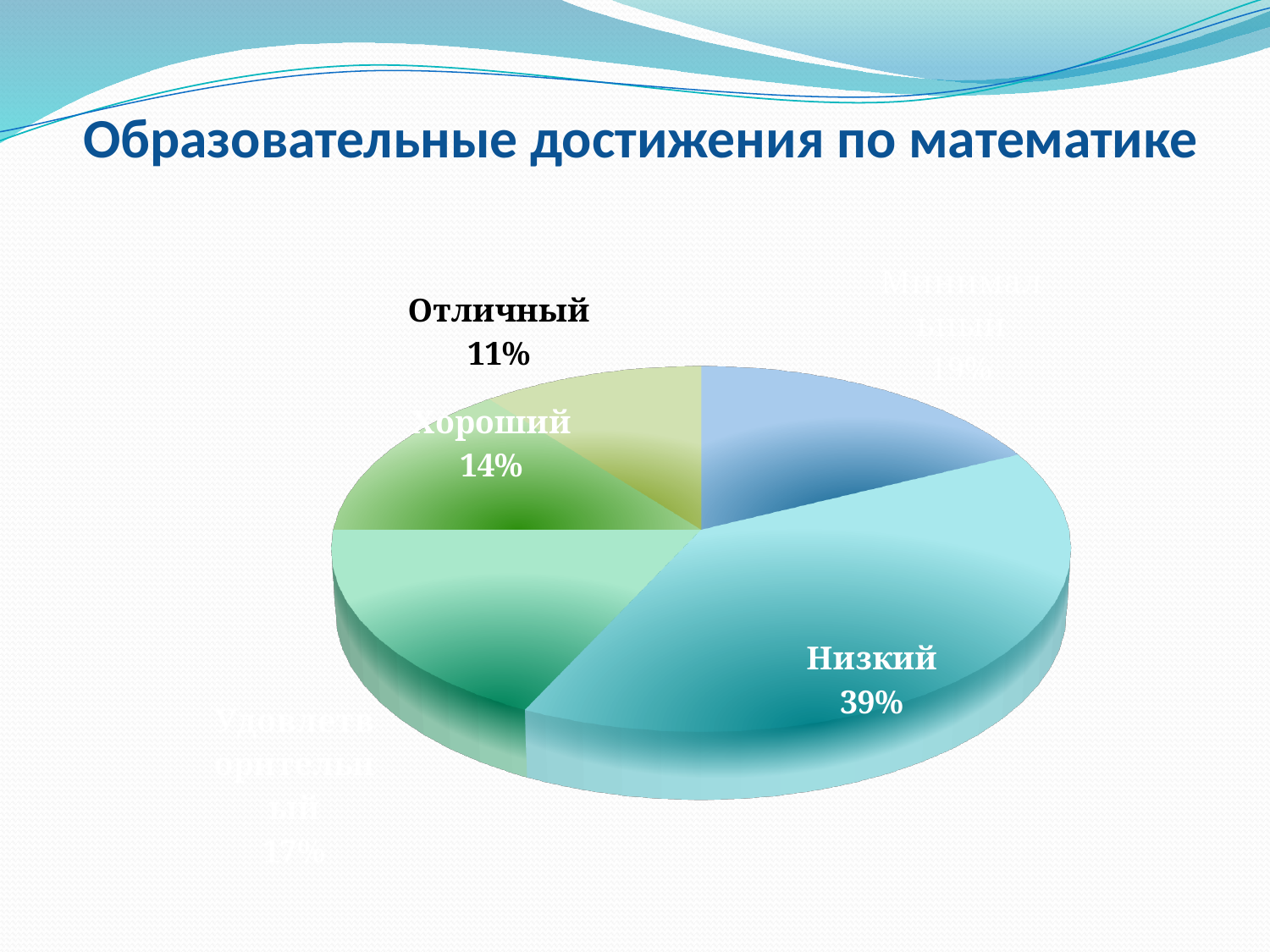
What percentage is shown for the Низкий slice? 39% What percentage is shown for the Отличный slice? 11% Which slice of the pie is the smallest? Отличный What is the difference in percentage points between the Хороший and Отличный slices? 3 How many slices does the pie chart have? 5 What kind of chart is shown on the slide? pie chart Which slice is larger, Низкий or Хороший? Низкий What is the difference in percentage points between the Низкий and Хороший slices? 25 Which slice is larger, Хороший or Отличный? Хороший Which slice of the pie is the largest? Низкий What is the title of the chart? Образовательные достижения по математике What percentage is shown for the Хороший slice? 14%